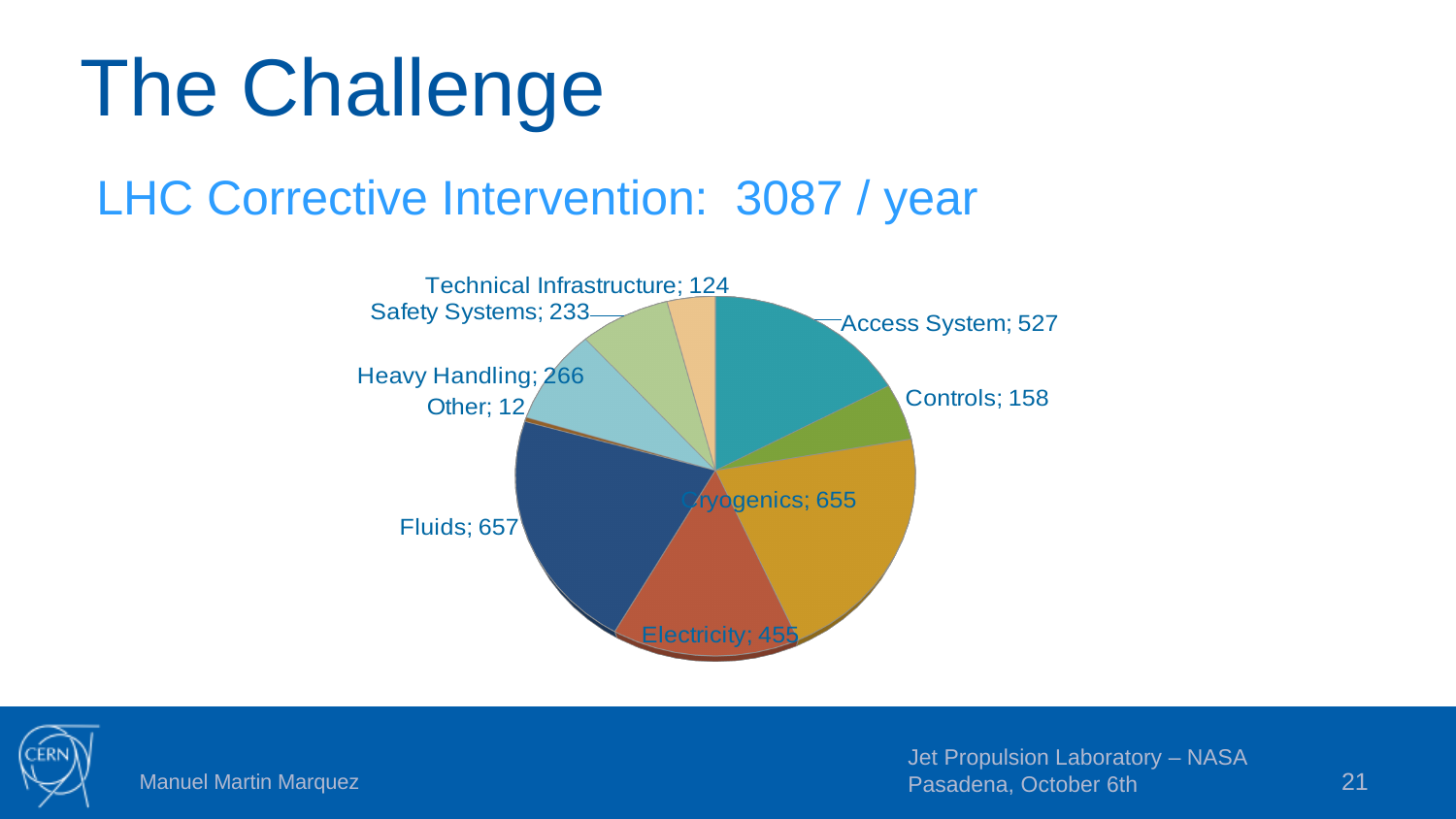
What is the difference between the values for Fluids and Electricity? 202 What is the value for Technical Infrastructure in the pie chart? 124 Which is larger, the value for Safety Systems or the value for Heavy Handling? Heavy Handling How many categories are shown in the pie chart? 9 Which category has the smallest slice in the pie chart? Other What total number of LHC corrective interventions per year does the slide state? 3087 / year What is the value for Cryogenics in the pie chart? 655 What is the difference between the values for Access System and Controls? 369 Which is larger, the value for Access System or the value for Electricity? Access System What is the value for Access System in the pie chart? 527 What kind of chart is shown on the slide? Pie chart What is the value for Heavy Handling in the pie chart? 266